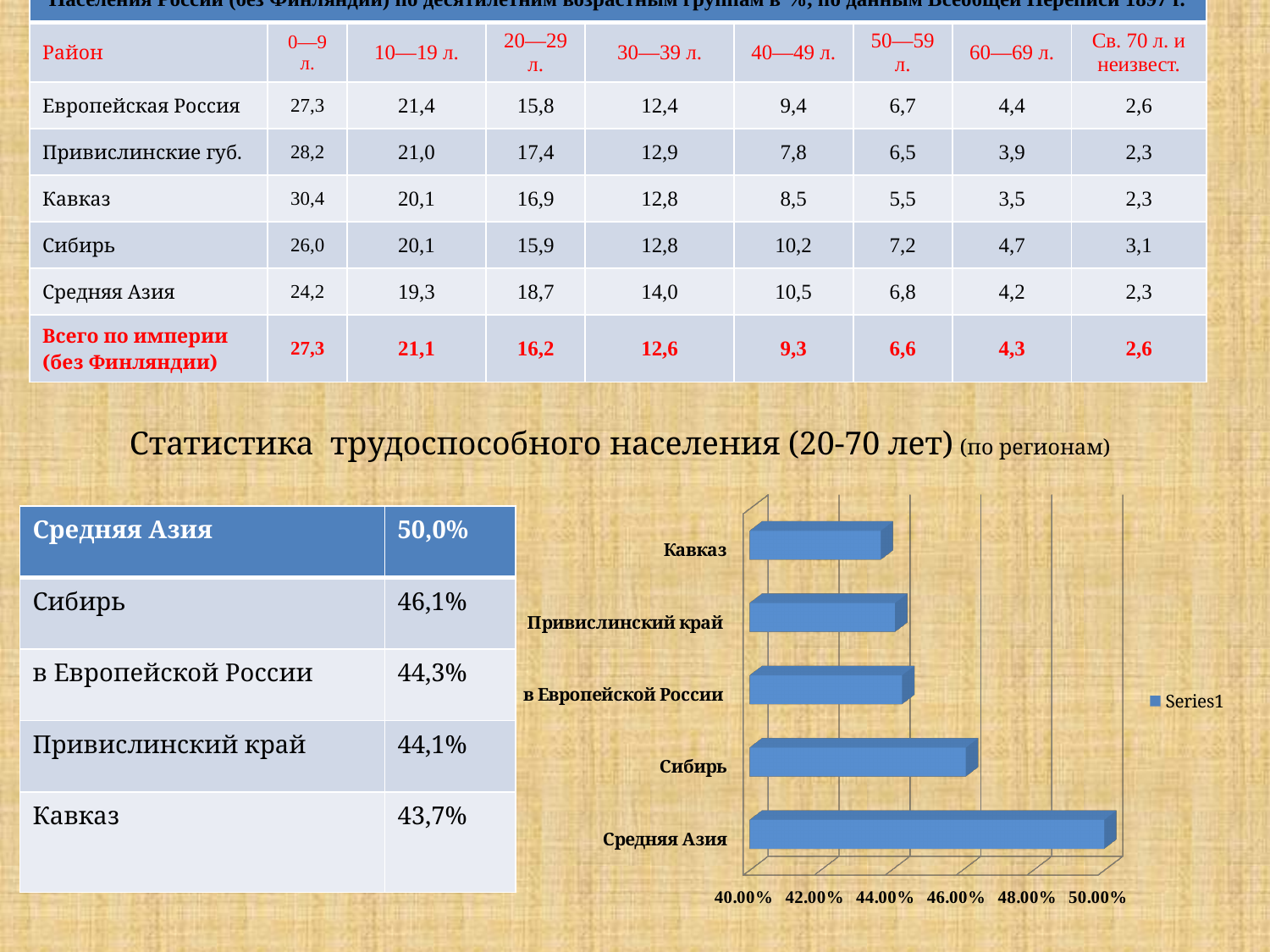
How many series does the chart legend list? 1 What is the name of the series shown in the chart legend? Series1 Which region has the longest bar in the chart? Средняя Азия Which region is listed at the top of the chart's category axis? Кавказ What kind of chart is shown on the slide? bar chart How many regions (categories) are plotted in the bar chart? 5 Is the value for Привислинский край greater or less than 46.00%? less In the chart, which bar is longer: Средняя Азия or Сибирь? Средняя Азия In the chart, which bar is longer: Сибирь or Кавказ? Сибирь Which region has the shortest bar in the chart? Кавказ Is the value for Средняя Азия greater or less than 48.00%? greater Is the value for Кавказ greater or less than 42.00%? greater